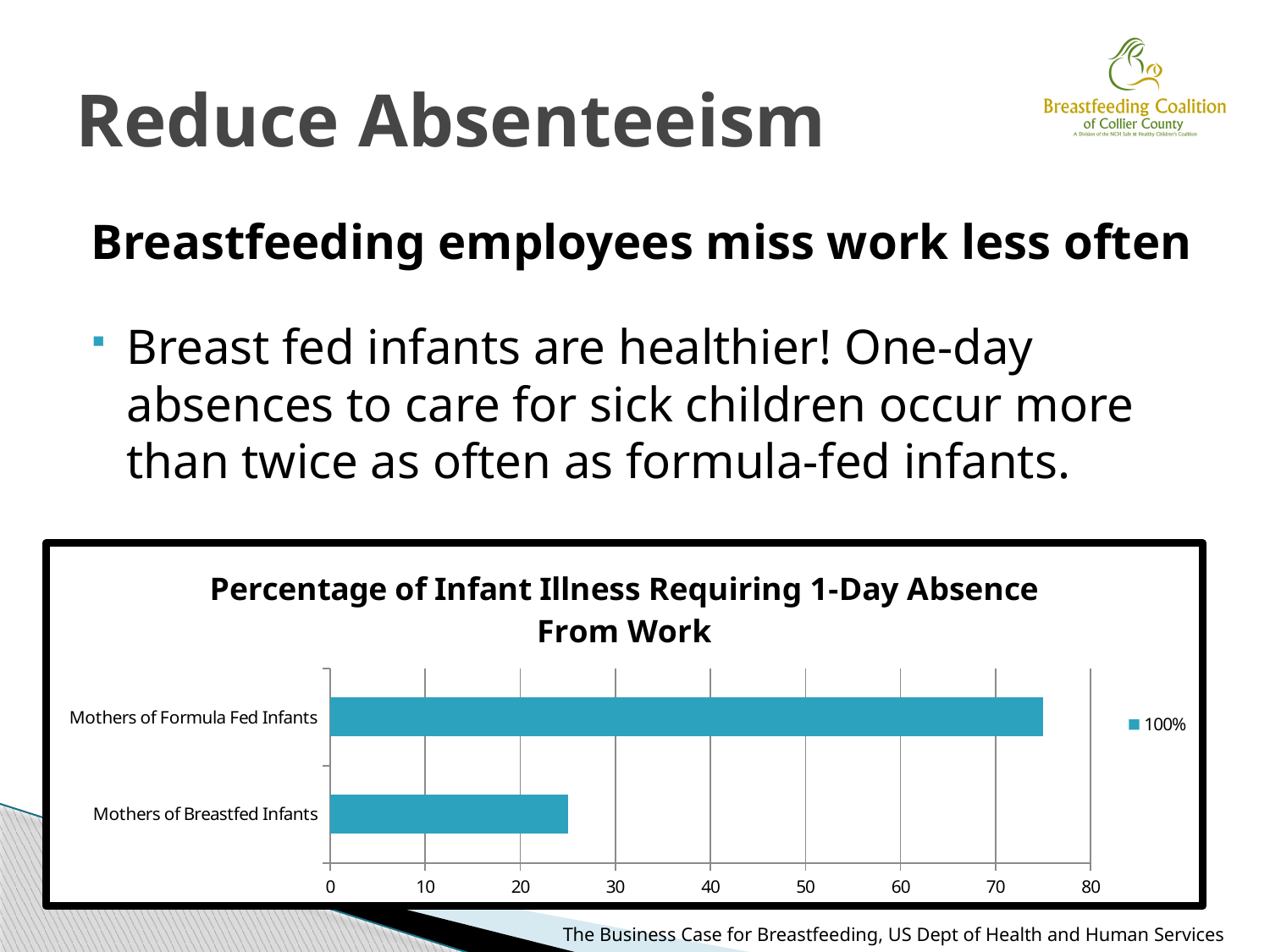
Is the value for Mothers of Formula Fed Infants greater or less than 80? less Which category has the lowest value in the chart? Mothers of Breastfed Infants Is the value for Mothers of Breastfed Infants greater or less than 30? less Which category has the highest value in the chart? Mothers of Formula Fed Infants How many categories are plotted in the chart? 2 Is the value for Mothers of Formula Fed Infants greater or less than 70? greater How many series does the chart legend list? 1 What is the legend entry shown in the chart? 100% Which is larger: the value for Mothers of Formula Fed Infants or the value for Mothers of Breastfed Infants? Mothers of Formula Fed Infants What kind of chart is shown on the slide? bar chart What is the title of the chart? Percentage of Infant Illness Requiring 1-Day Absence From Work